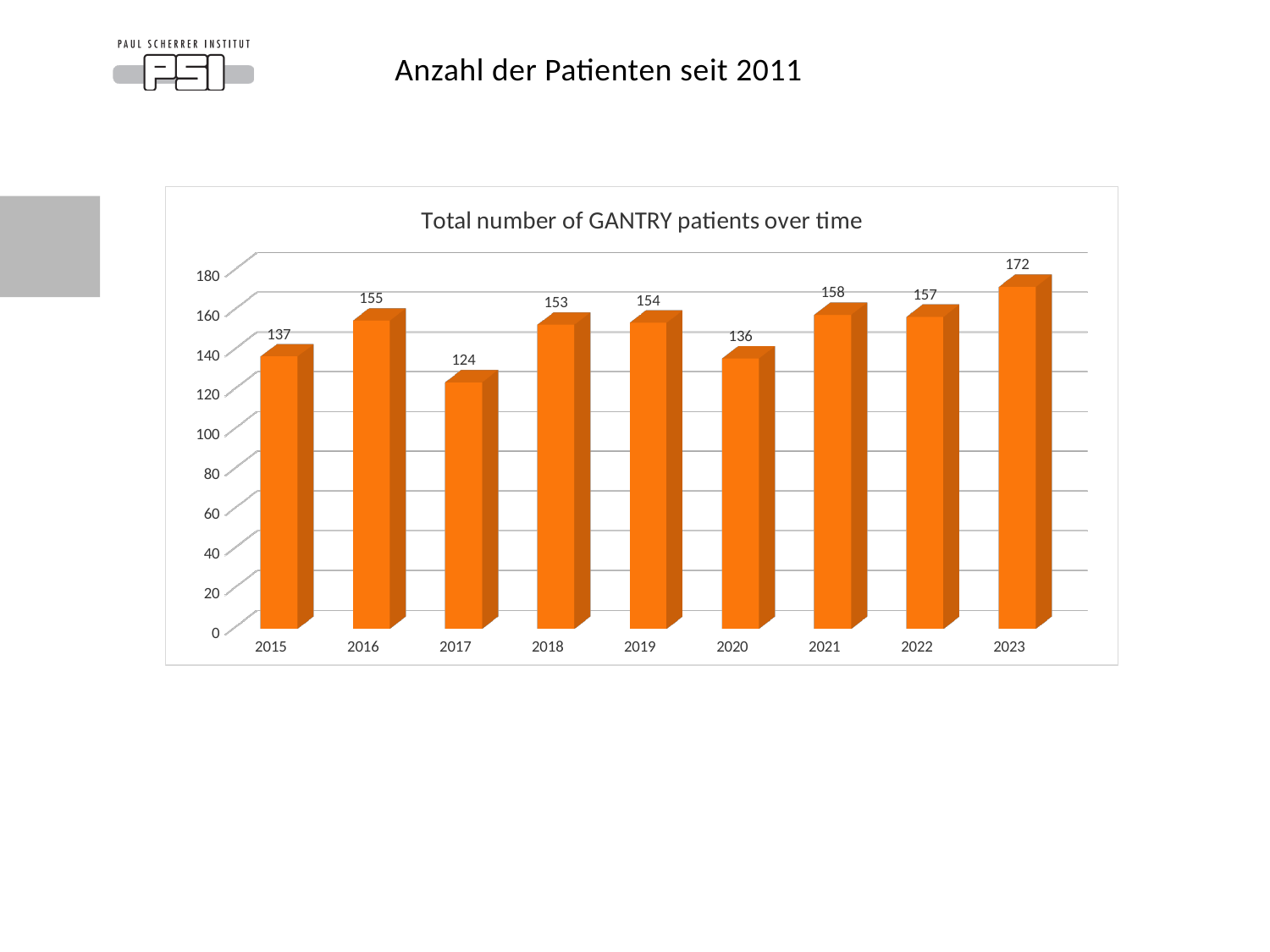
How many years are shown on the x axis of the chart? 9 What is the title of the chart? Total number of GANTRY patients over time What is the total number of GANTRY patients in 2015? 137 Which year has the highest number of GANTRY patients? 2023 What is the total number of GANTRY patients in 2023? 172 Which year has the lowest number of GANTRY patients? 2017 What is the difference in the number of GANTRY patients between 2016 and 2015? 18 Which year had more GANTRY patients, 2018 or 2020? 2018 What kind of chart is shown on the slide? bar chart What is the total number of GANTRY patients in 2020? 136 Is the value for 2021 greater or less than 140? greater What is the difference in the number of GANTRY patients between 2023 and 2017? 48